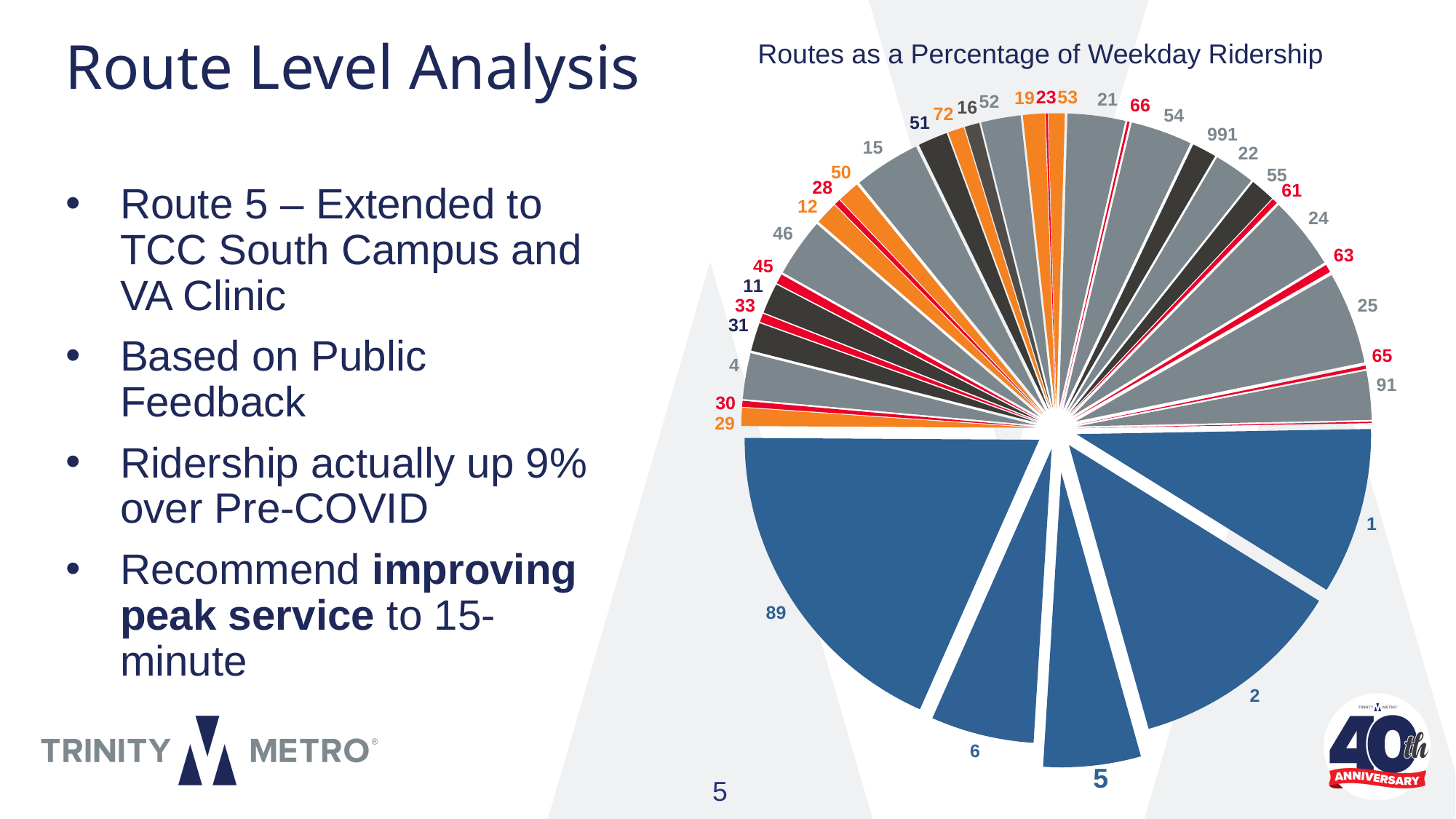
What kind of chart is shown on the slide? Pie chart Which slice is larger, route 89 or route 2? 89 Which route has the largest slice in the pie chart? 89 Which slice is larger, route 89 or route 5? 89 How many slices in the pie chart are coloured blue? 5 What colour is the slice for route 5 in the pie chart? Blue What is the title of the pie chart? Routes as a Percentage of Weekday Ridership Which slice is larger, route 1 or route 29? 1